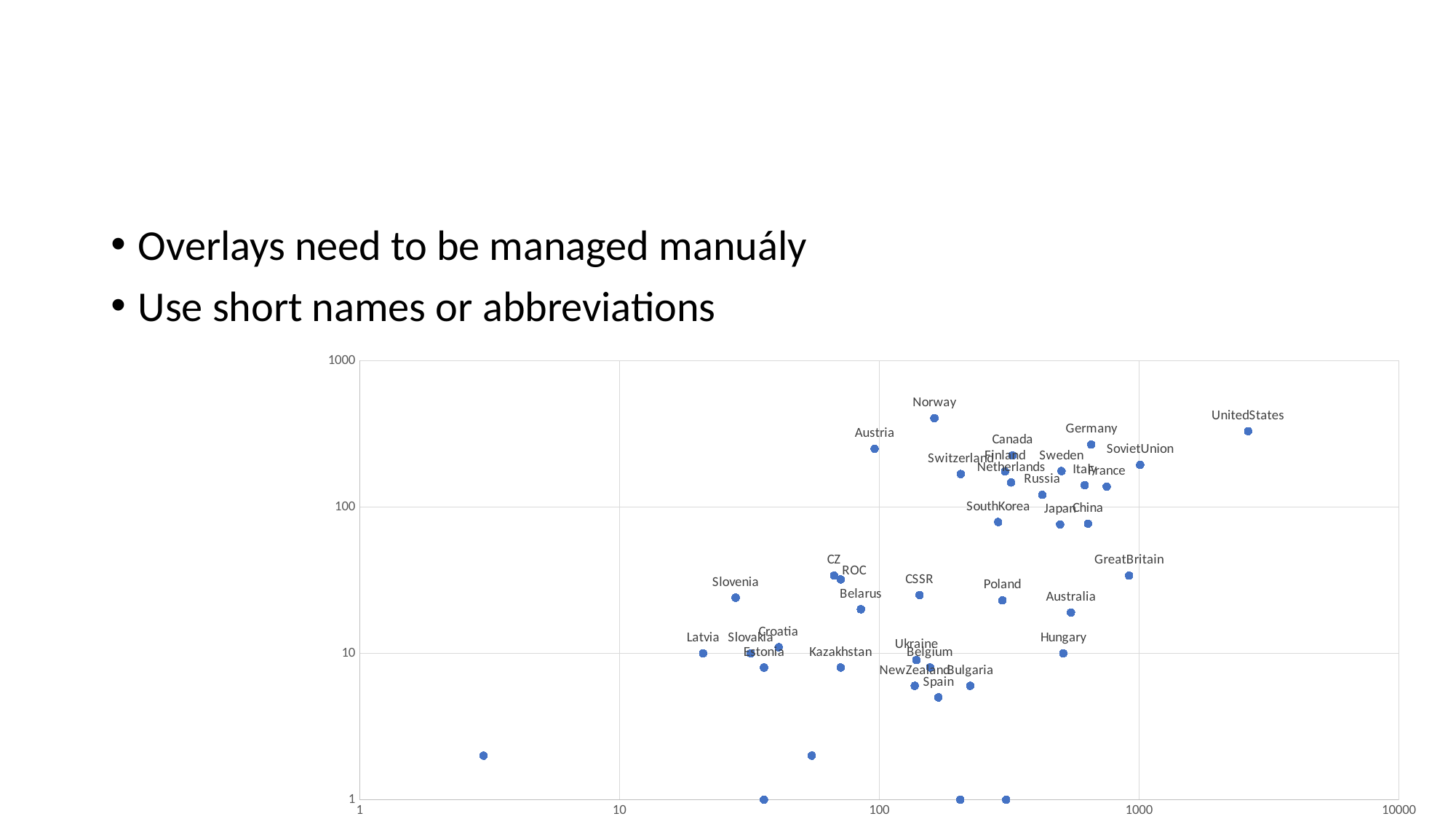
Is the vertical-axis value for Spain greater or less than 10? less Which has the higher vertical-axis value, Norway or Austria? Norway Which labelled country has the highest value on the vertical axis? Norway What is the highest tick value shown on the horizontal axis? 10000 Which has the higher vertical-axis value, Slovenia or Latvia? Slovenia Is the horizontal-axis value for UnitedStates greater or less than 1000? greater What kind of chart is shown on the slide? scatter chart Which labelled country has the highest value on the horizontal axis? UnitedStates Which has the larger horizontal-axis value, UnitedStates or Germany? UnitedStates Is the vertical-axis value for Norway greater or less than 100? greater